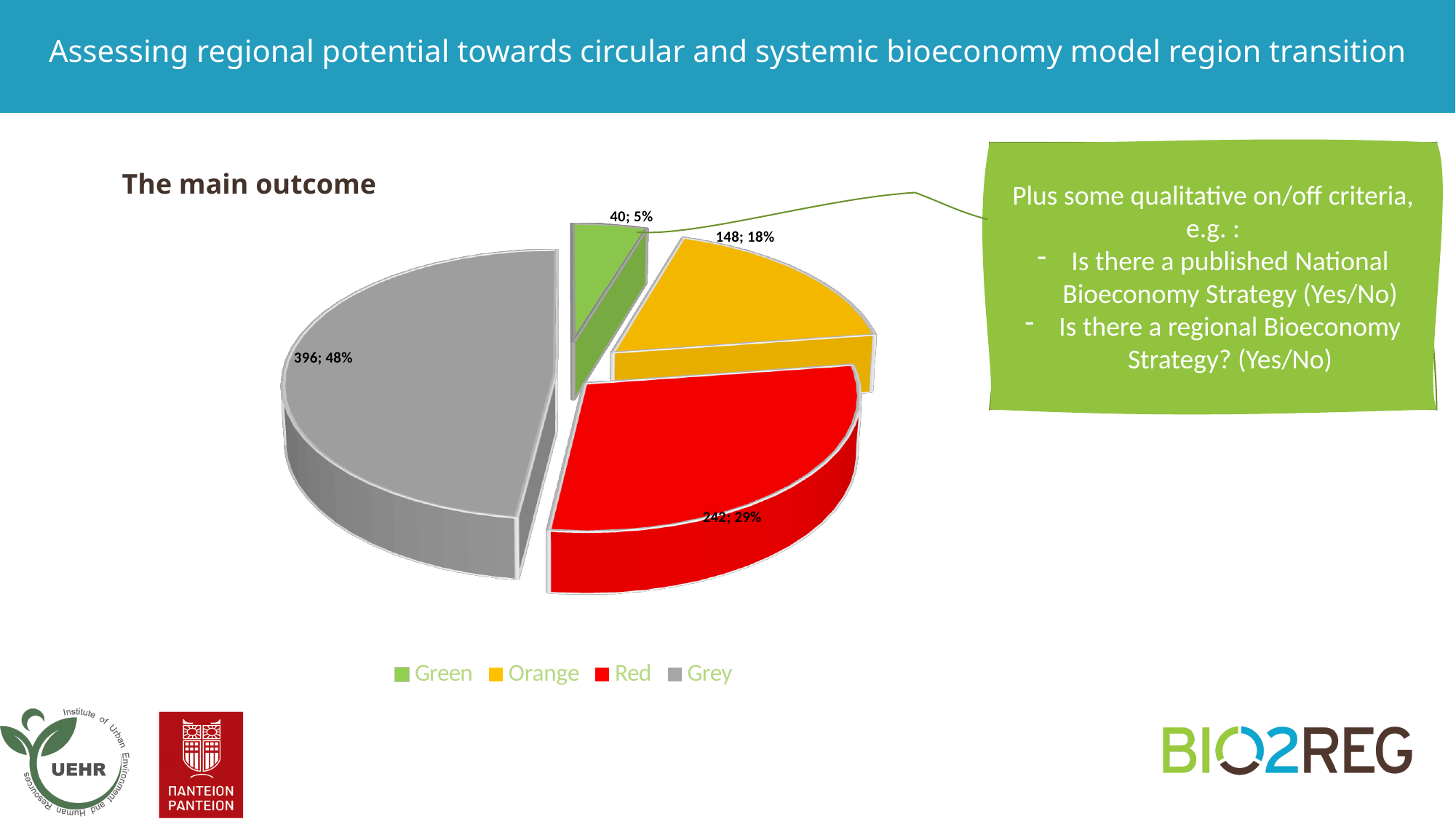
What percentage share does the Grey slice have? 48% How many categories does the legend list? 4 What is the value for the Grey slice? 396 What is the value for the Orange slice? 148 Which is larger, the Orange value or the Red value? Red What kind of chart is shown on the slide? pie chart Which category has the smallest slice? Green What is the value for the Red slice? 242 What percentage share does the Green slice have? 5% What is the difference between the Grey and Red values? 154 Which category has the largest slice? Grey What is the value for the Green slice? 40